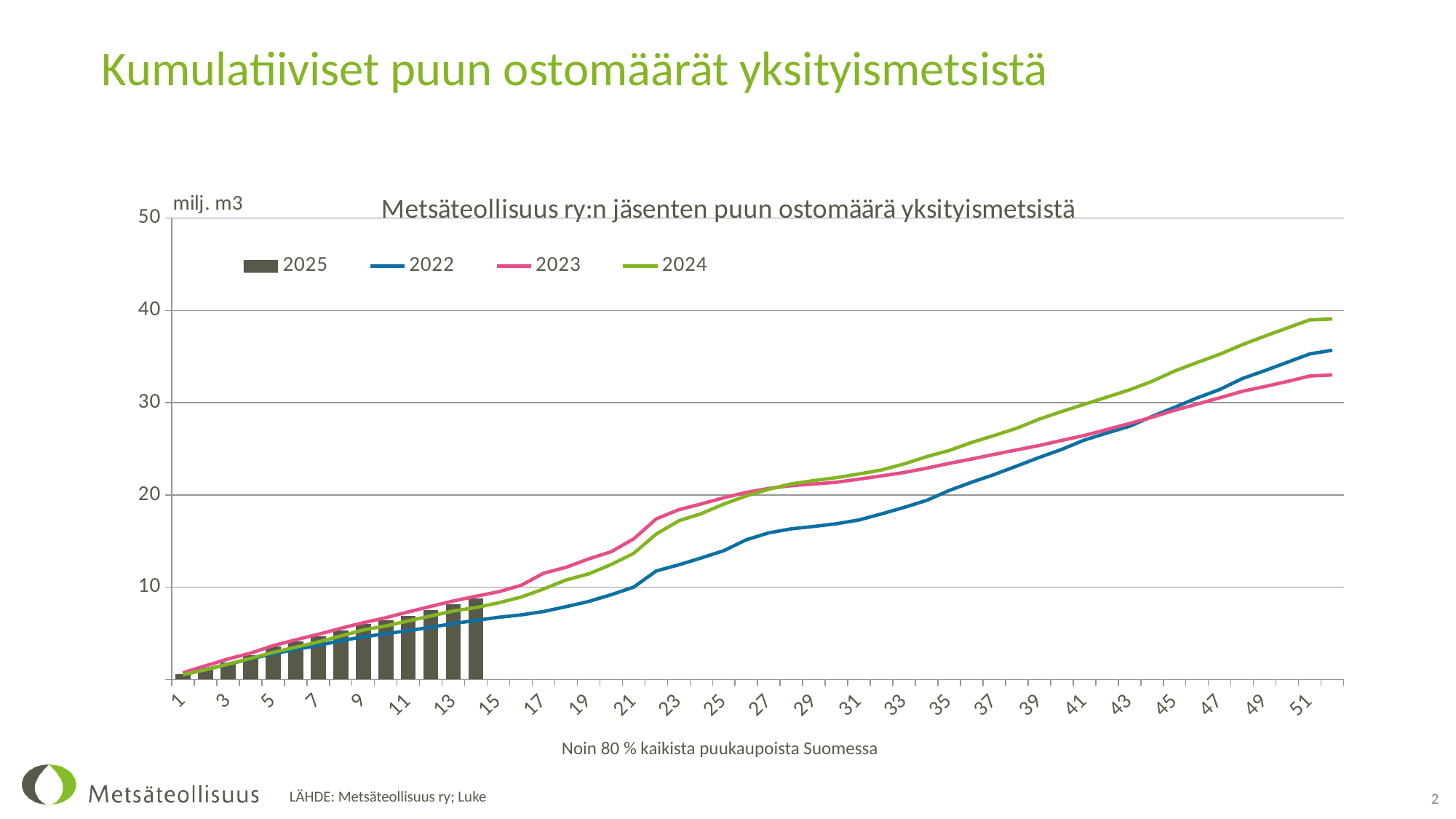
Is the value of the 2022 line at week 27 greater or less than 20? less At week 52, which line is higher, 2022 or 2023? 2022 At week 27, which line is higher, 2022 or 2023? 2023 Which series has the lowest value at the right end of the chart (week 52)? 2023 Is the value of the 2024 line at week 52 greater or less than 40? less Do the values of the 2024 line rise or fall along the x axis? Rise Which series in the legend is drawn as bars rather than a line? 2025 What is the title of the chart? Metsäteollisuus ry:n jäsenten puun ostomäärä yksityismetsistä Which series has the highest value at the right end of the chart (week 52)? 2024 How many series does the chart legend list? 4 What kind of chart is this? Combined bar and line chart Is the value of the 2022 line at week 52 greater or less than 30? greater